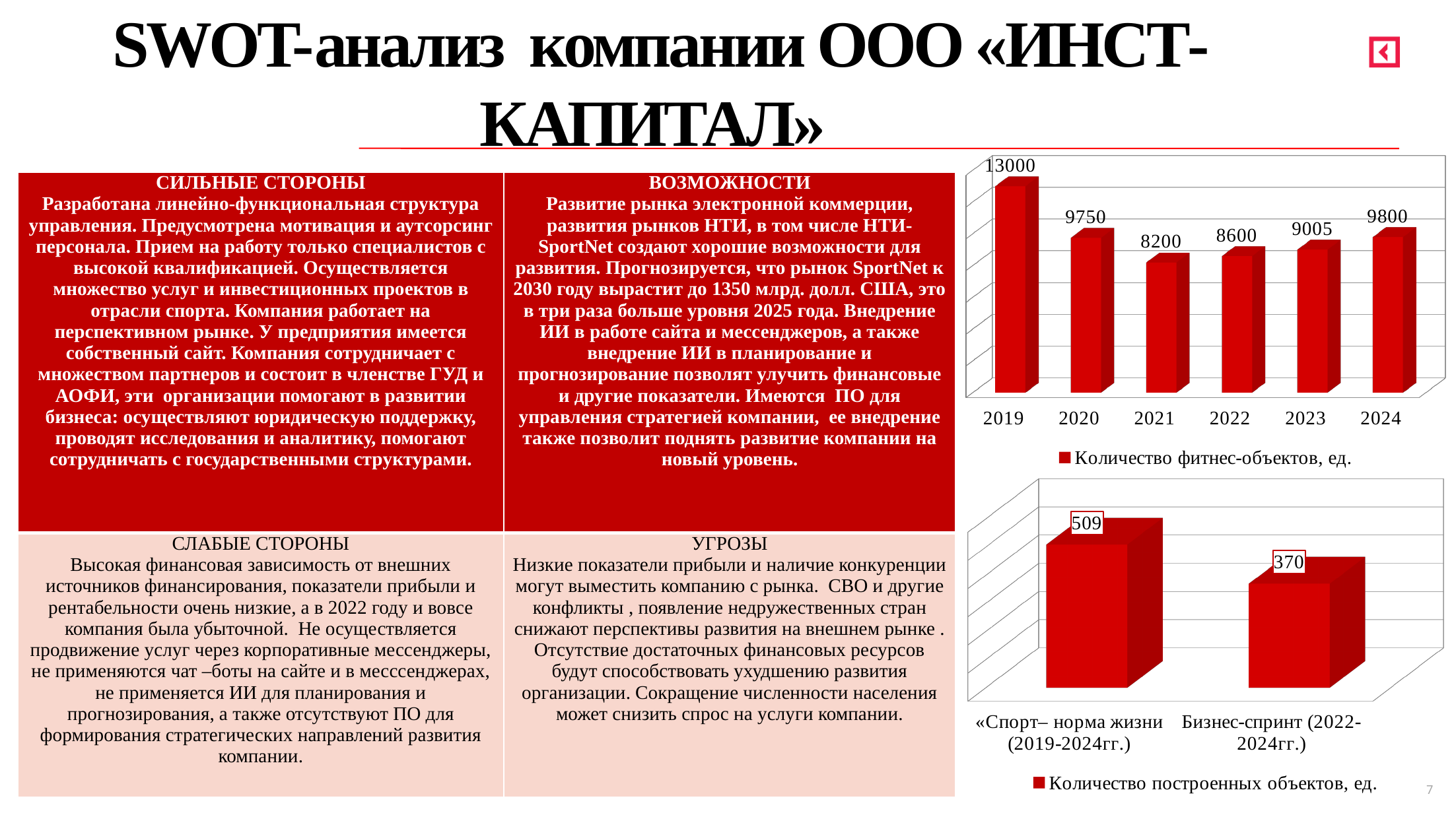
In the top-right chart (Количество фитнес-объектов, ед.), how many years are shown on the x axis? 6 In the bottom-right chart (Количество построенных объектов, ед.), what is the value for Бизнес-спринт (2022-2024гг.)? 370 In the bottom-right chart (Количество построенных объектов, ед.), what is the difference between the two bars? 139 In the top-right chart (Количество фитнес-объектов, ед.), which is larger: the value for 2022 or the value for 2024? 2024 In the top-right chart (Количество фитнес-объектов, ед.), do the values rise or fall from 2021 to 2024? rise What kind of chart is the bottom-right chart (Количество построенных объектов, ед.)? bar chart In the bottom-right chart (Количество построенных объектов, ед.), what is the value for «Спорт– норма жизни (2019-2024гг.)»? 509 In the top-right chart (Количество фитнес-объектов, ед.), which year has the lowest value? 2021 In the top-right chart (Количество фитнес-объектов, ед.), what is the difference between the values for 2019 and 2020? 3250 In the top-right chart (Количество фитнес-объектов, ед.), which year has the highest value? 2019 In the top-right chart (Количество фитнес-объектов, ед.), what is the value for 2023? 9005 In the top-right chart (Количество фитнес-объектов, ед.), what is the value for 2019? 13000